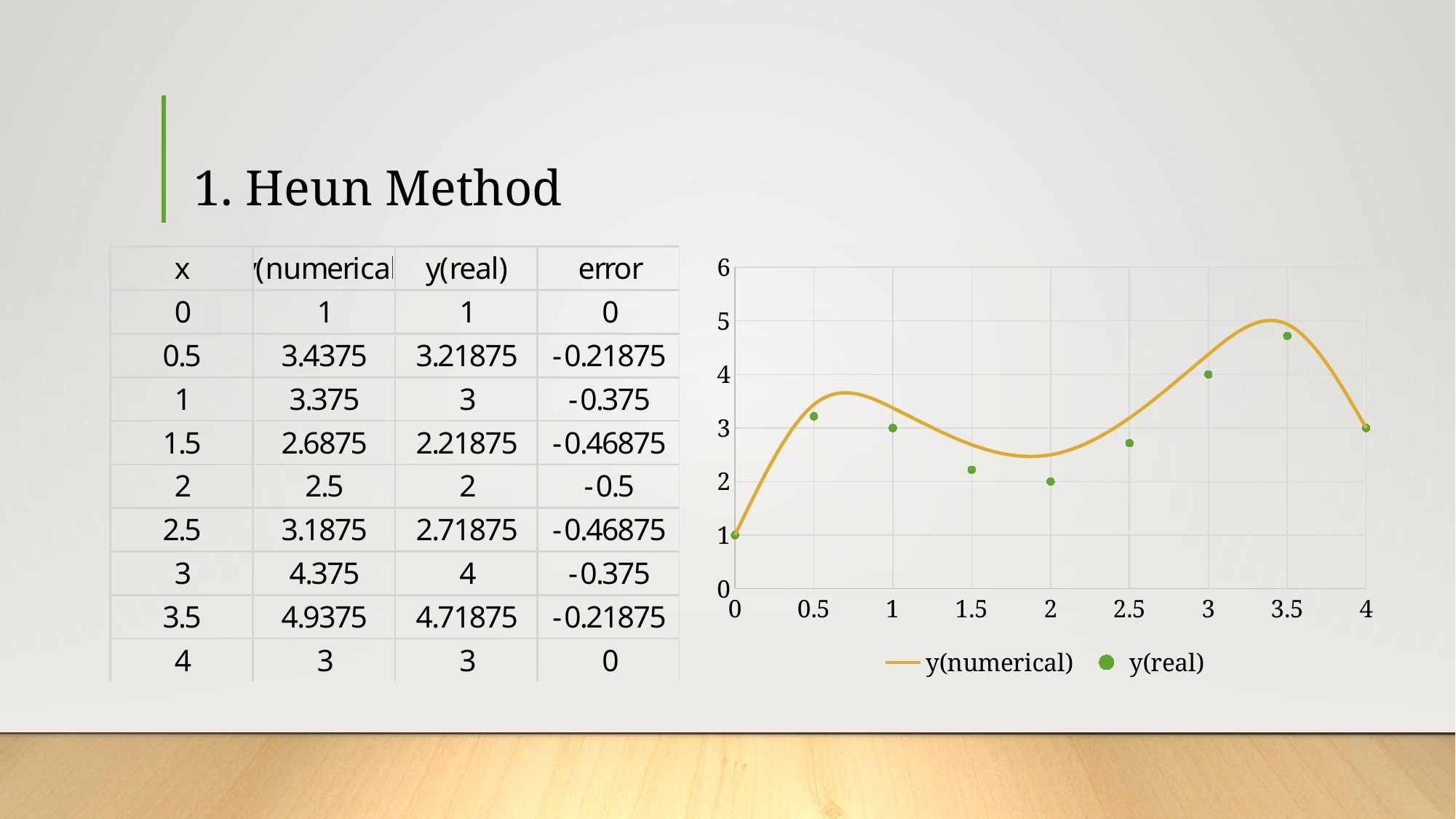
At which x value does y(real) reach its highest point on the chart? 3.5 How many series does the chart legend list? 2 What is the value of y(numerical) at x = 4 on the chart? 3 How many y(real) points are plotted on the chart? 9 Is the value of y(numerical) at x = 3.5 greater or less than 4? greater Which is larger at x = 1.5: y(numerical) or y(real)? y(numerical) What is the value of y(real) at x = 1 on the chart? 3 What kind of chart is shown on the slide? line chart What are the two series named in the chart legend? y(numerical) and y(real) Is the value of y(numerical) at x = 2 greater or less than 3? less What is the value of y(real) at x = 3 on the chart? 4 What is the value of y(real) at x = 2 on the chart? 2